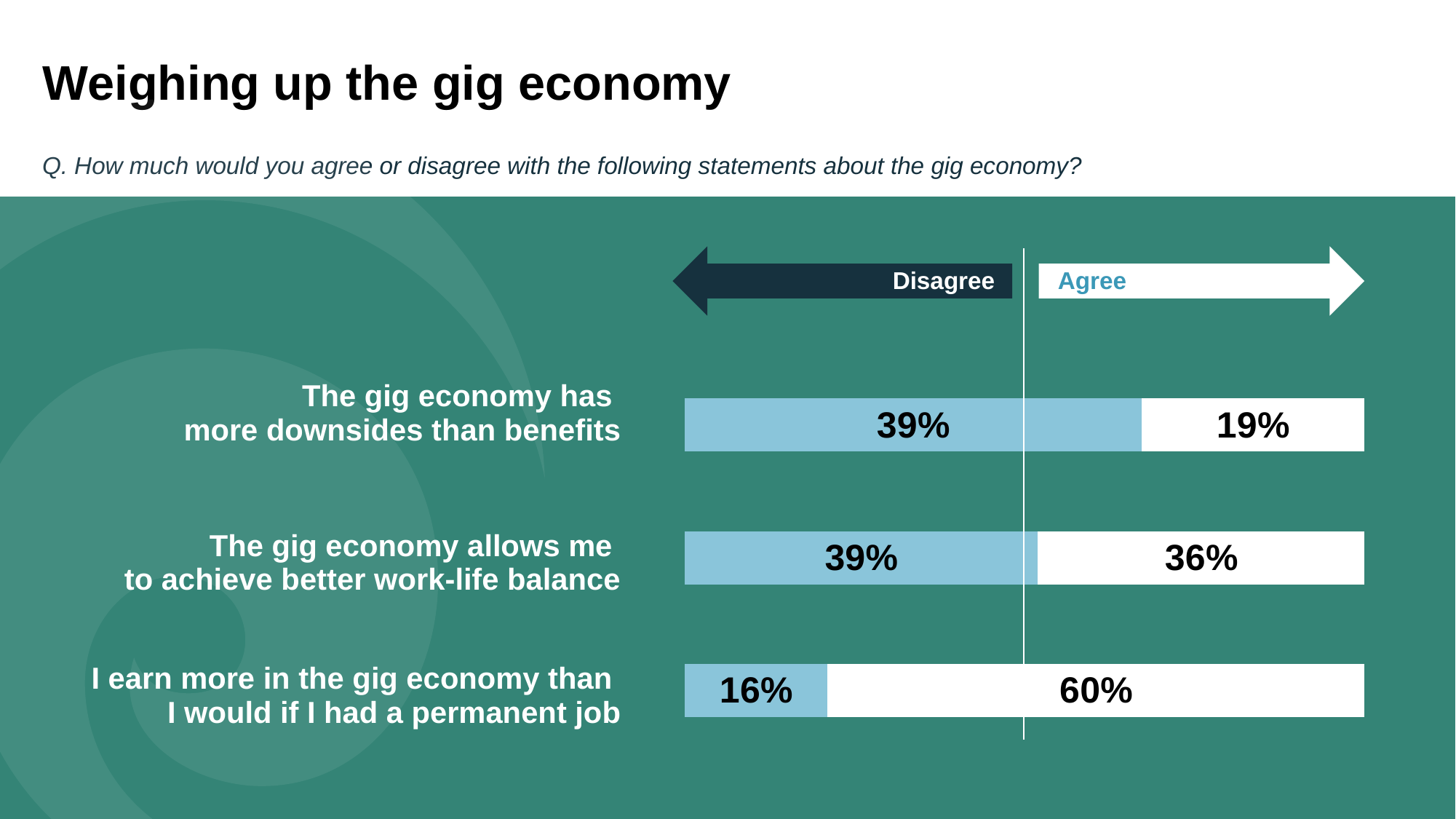
Which statement has the highest Agree percentage? I earn more in the gig economy than I would if I had a permanent job What is the difference between the Agree and Disagree percentages for the statement 'I earn more in the gig economy than I would if I had a permanent job'? 44 percentage points What percentage agree that the gig economy has more downsides than benefits? 19% Which statement has the lowest Agree percentage? The gig economy has more downsides than benefits What percentage agree that they earn more in the gig economy than they would if they had a permanent job? 60% For the statement 'The gig economy allows me to achieve better work-life balance', is the Disagree or Agree percentage larger? Disagree What percentage disagree that they earn more in the gig economy than they would if they had a permanent job? 16% What kind of chart is shown on the slide? Bar chart What is the combined Agree and Disagree percentage for the statement 'The gig economy has more downsides than benefits'? 58% How many statements are shown in the chart? 3 What percentage disagree that the gig economy allows them to achieve better work-life balance? 39% How many response categories does the chart show for each statement? 2